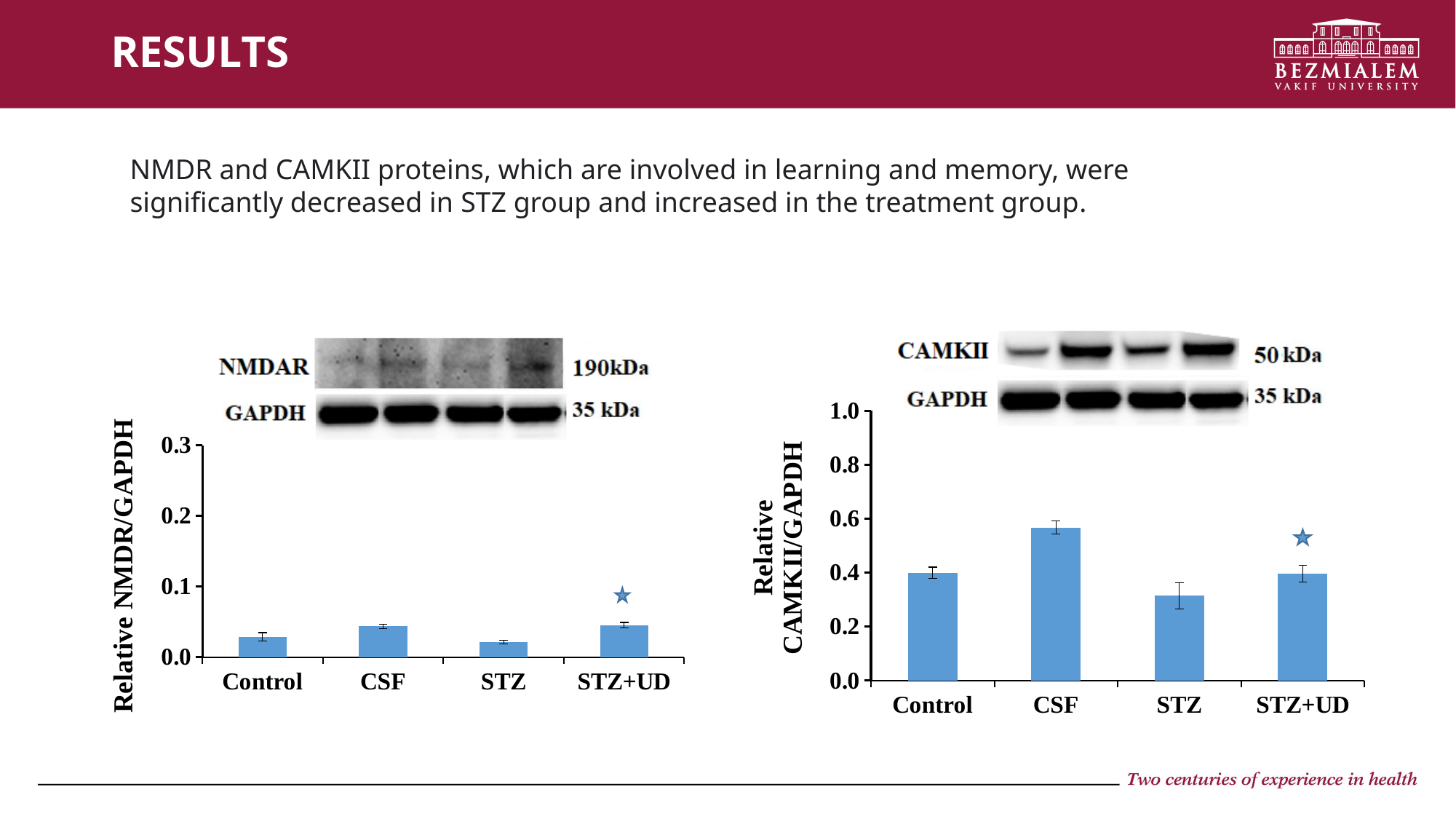
In the Relative CAMKII/GAPDH chart on the right, which category has the highest value? CSF In the Relative CAMKII/GAPDH chart on the right, is the value for CSF greater or less than 0.4? greater In the Relative CAMKII/GAPDH chart on the right, which category has the lowest value? STZ In the Relative NMDR/GAPDH chart on the left, which category has the lowest value? STZ In the Relative CAMKII/GAPDH chart on the right, which is larger, the value for Control or the value for CSF? CSF How many categories are shown on the x axis of the Relative CAMKII/GAPDH chart on the right? 4 In the Relative NMDR/GAPDH chart on the left, is the value for CSF greater or less than 0.1? less In the Relative NMDR/GAPDH chart on the left, which is larger, the value for CSF or the value for STZ? CSF In the Relative CAMKII/GAPDH chart on the right, is the value for STZ greater or less than 0.4? less What is the y-axis label of the chart on the right? Relative CAMKII/GAPDH What kind of chart is the Relative NMDR/GAPDH chart on the left? bar chart